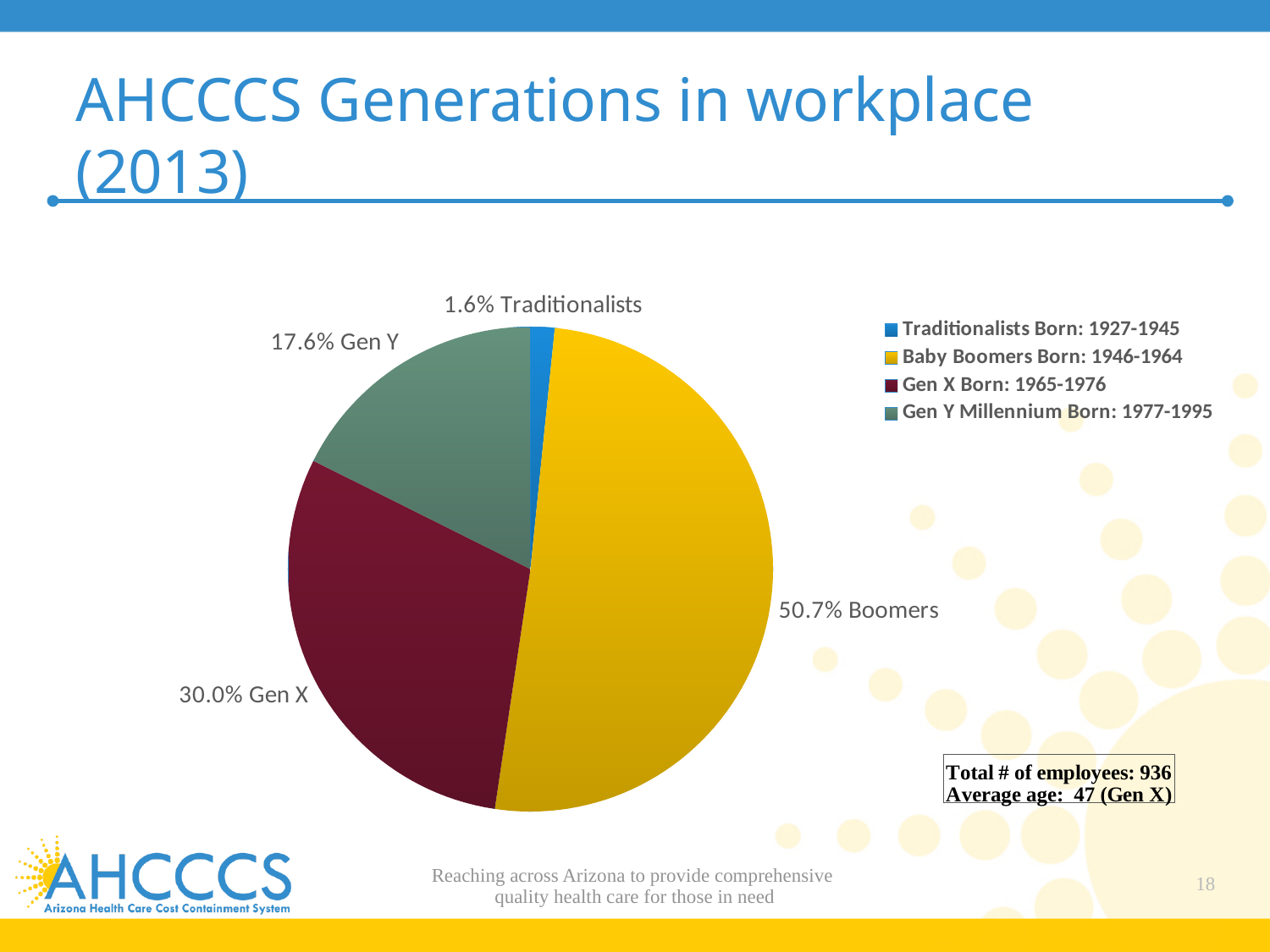
Which generation has the smallest slice of the pie? Traditionalists How many entries does the legend list? 4 According to the legend, what birth years define Gen X? 1965-1976 What share of the pie do Boomers represent? 50.7% What kind of chart is shown on the slide? Pie chart Which slice is larger, Gen X or Gen Y? Gen X What is the difference in percentage points between the Gen X and Gen Y slices? 12.4 What share of the pie does Gen Y represent? 17.6% What share of the pie do Traditionalists represent? 1.6% How many slices does the pie chart have? 4 Which generation has the largest slice of the pie? Boomers